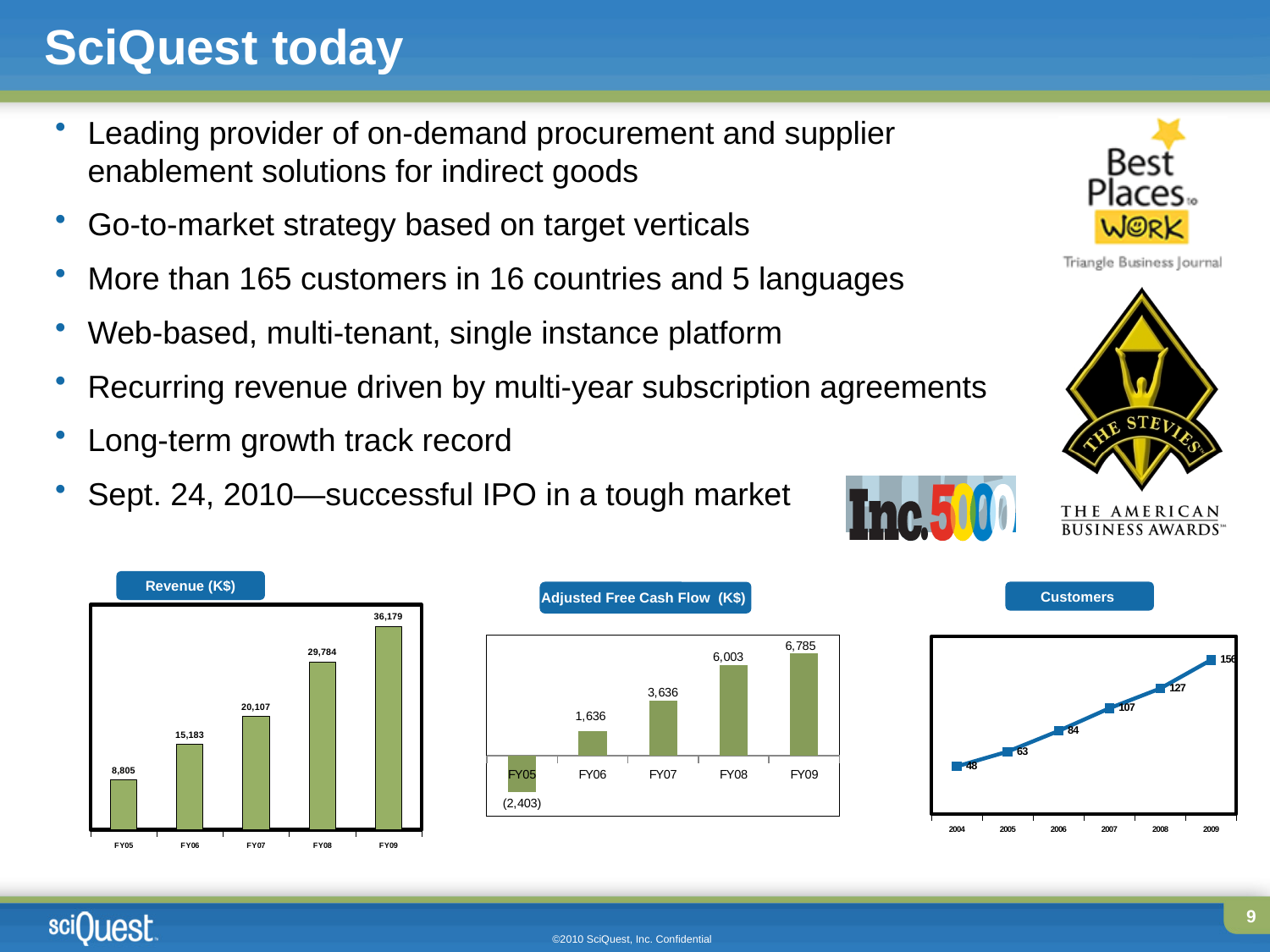
In the Revenue (K$) chart, which fiscal year has the highest revenue? FY09 In the Revenue (K$) chart, what is the revenue for FY07? 20,107 What type of chart is the Revenue (K$) chart? Bar chart In the Revenue (K$) chart, what is the difference between FY09 and FY08 revenue? 6,395 In the Adjusted Free Cash Flow (K$) chart, what is the value for FY08? 6,003 In the Customers chart, how many customers were there in 2007? 107 In the Adjusted Free Cash Flow (K$) chart, which fiscal year has the lowest value? FY05 In the Adjusted Free Cash Flow (K$) chart, what is the value for FY05? (2,403) In the Adjusted Free Cash Flow (K$) chart, what is the difference between FY07 and FY06? 2,000 In the Customers chart, do the values rise or fall from 2004 to 2009? Rise In the Revenue (K$) chart, how many fiscal years are shown? 5 What type of chart is the Customers chart? Line chart